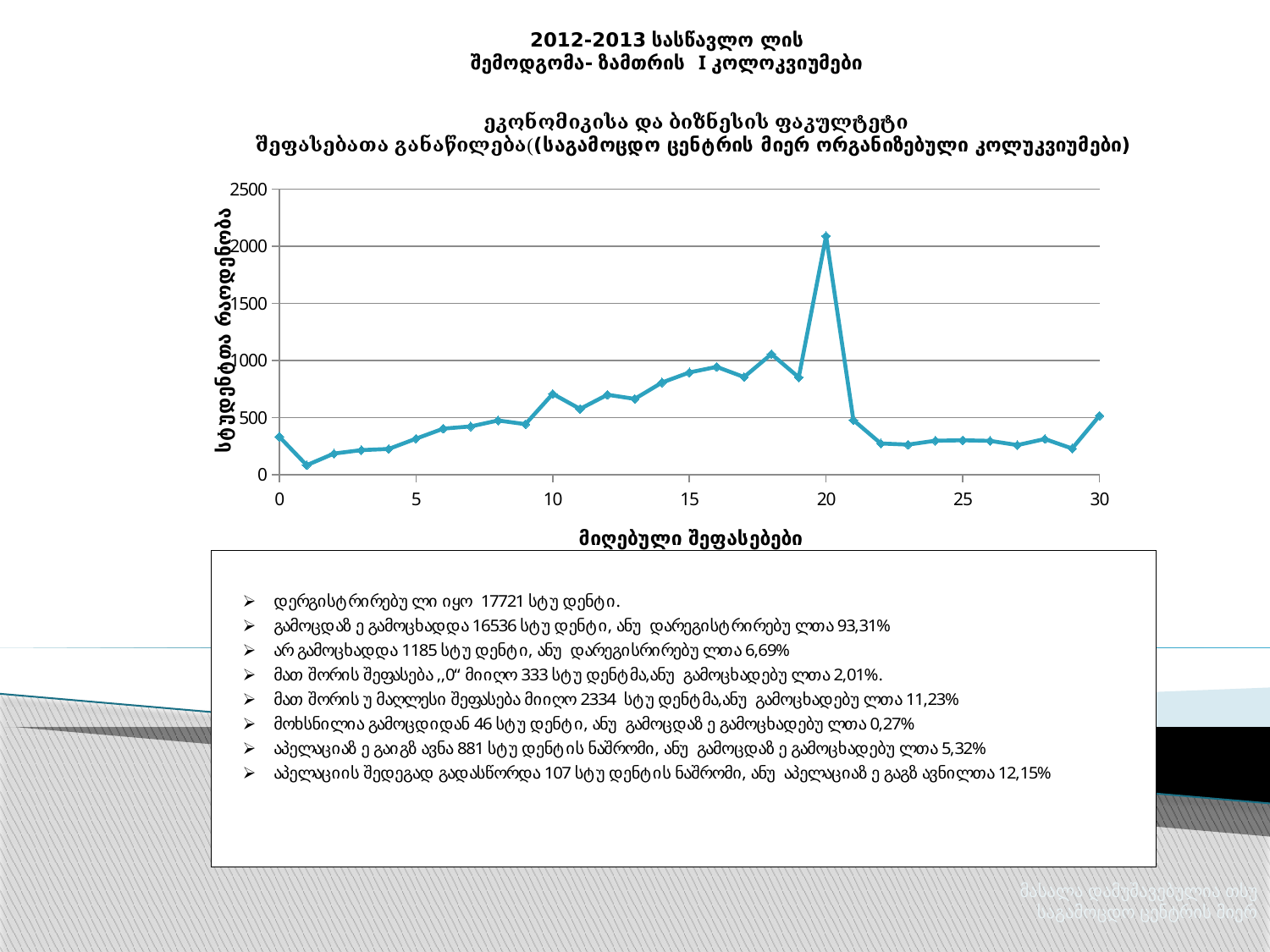
Is the value at x = 1 greater or less than 500? less What kind of chart is shown on the slide? line chart Does the line rise or fall between x = 20 and x = 22? fall Is the value at x = 25 greater or less than 500? less Which has the larger value, x = 20 or x = 10? 20 At which x-axis value (grade) does the line reach its lowest point? 1 Is the value at x = 15 greater or less than 1000? less What is the label of the vertical axis? სტუდენტთა რაოდენობა Which has the larger value, x = 10 or x = 1? 10 At which x-axis value (grade) does the line reach its highest point? 20